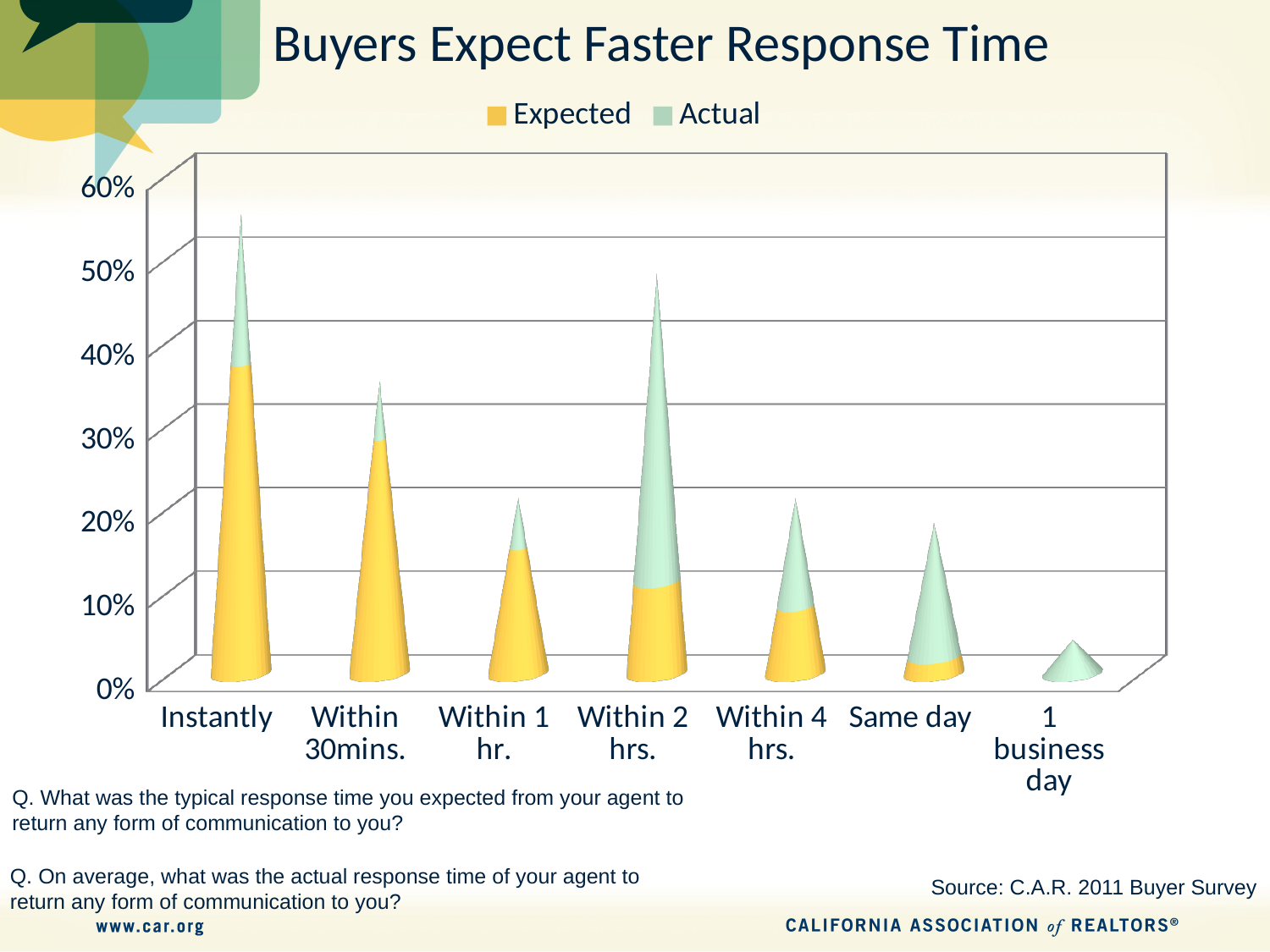
Is the Actual value for 1 business day greater or less than 10%? less Is the Expected value for Within 4 hrs. greater or less than 10%? less What is the title of the chart? Buyers Expect Faster Response Time Which category has the highest Expected value? Instantly What type of chart is shown on the slide? bar chart Is the Expected value for Instantly greater or less than 30%? greater How many series does the legend list? 2 Which is larger, the Expected value for Instantly or the Expected value for Within 1 hr.? Instantly How many response-time categories are shown on the x axis? 7 What are the two series named in the legend? Expected and Actual Which category has the lowest Expected value? 1 business day